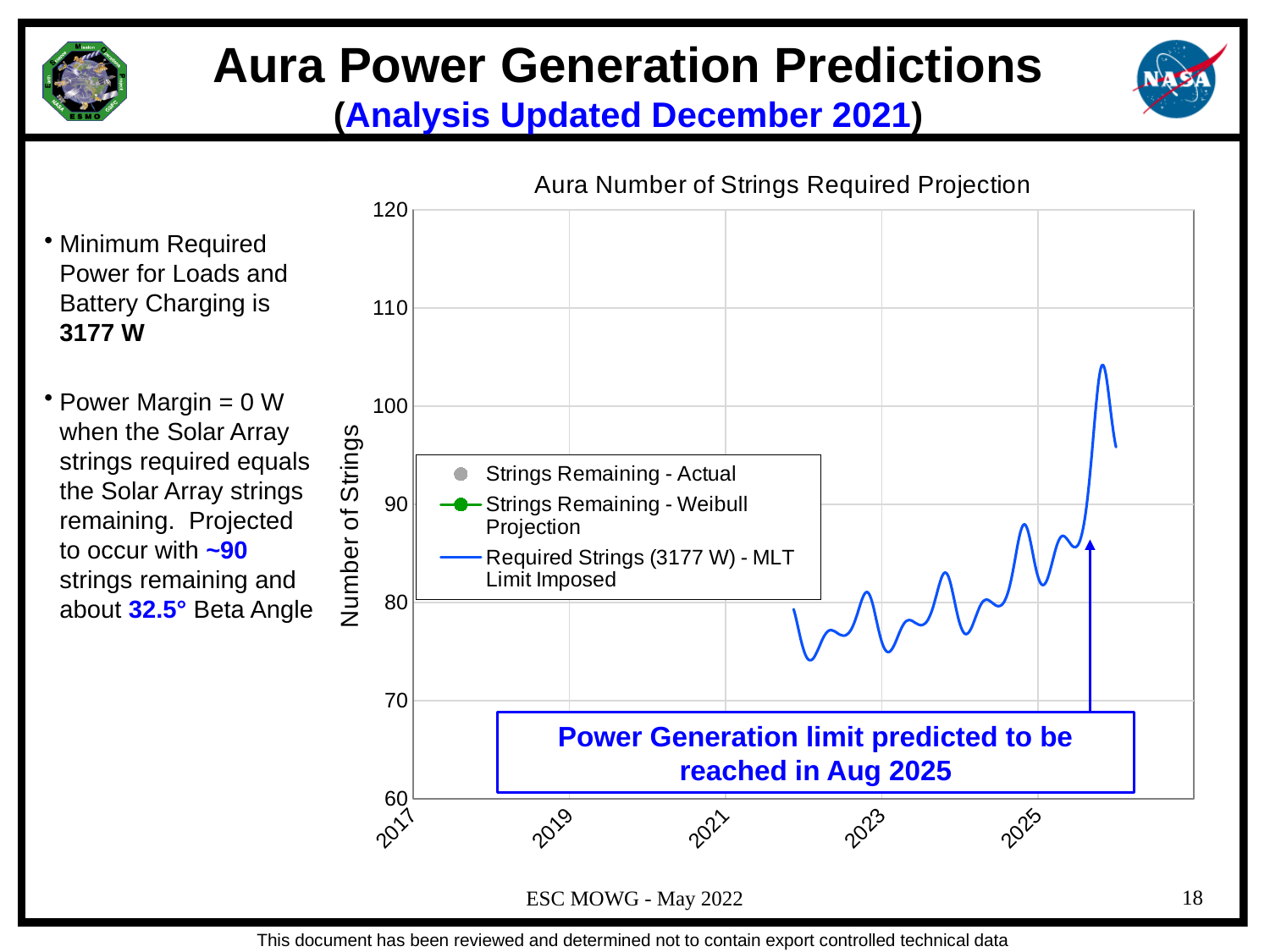
What is the highest value shown on the vertical axis of the chart? 120 What is the label of the vertical axis of the chart? Number of Strings How many series does the chart's legend list? 3 What is the first year labelled on the horizontal axis of the chart? 2017 What is the last year labelled on the horizontal axis of the chart? 2025 Is the lowest value of the Required Strings line, near 2022, greater or less than 80? less Is the value of the Required Strings line at 2025 greater or less than 80? greater What kind of chart is shown on the slide? line chart Does the Required Strings line generally rise or fall from 2022 to its peak after 2025? rise What is the lowest value shown on the vertical axis of the chart? 60 What is the title of the chart? Aura Number of Strings Required Projection Is the peak value of the Required Strings line, reached shortly after 2025, greater or less than 100? greater